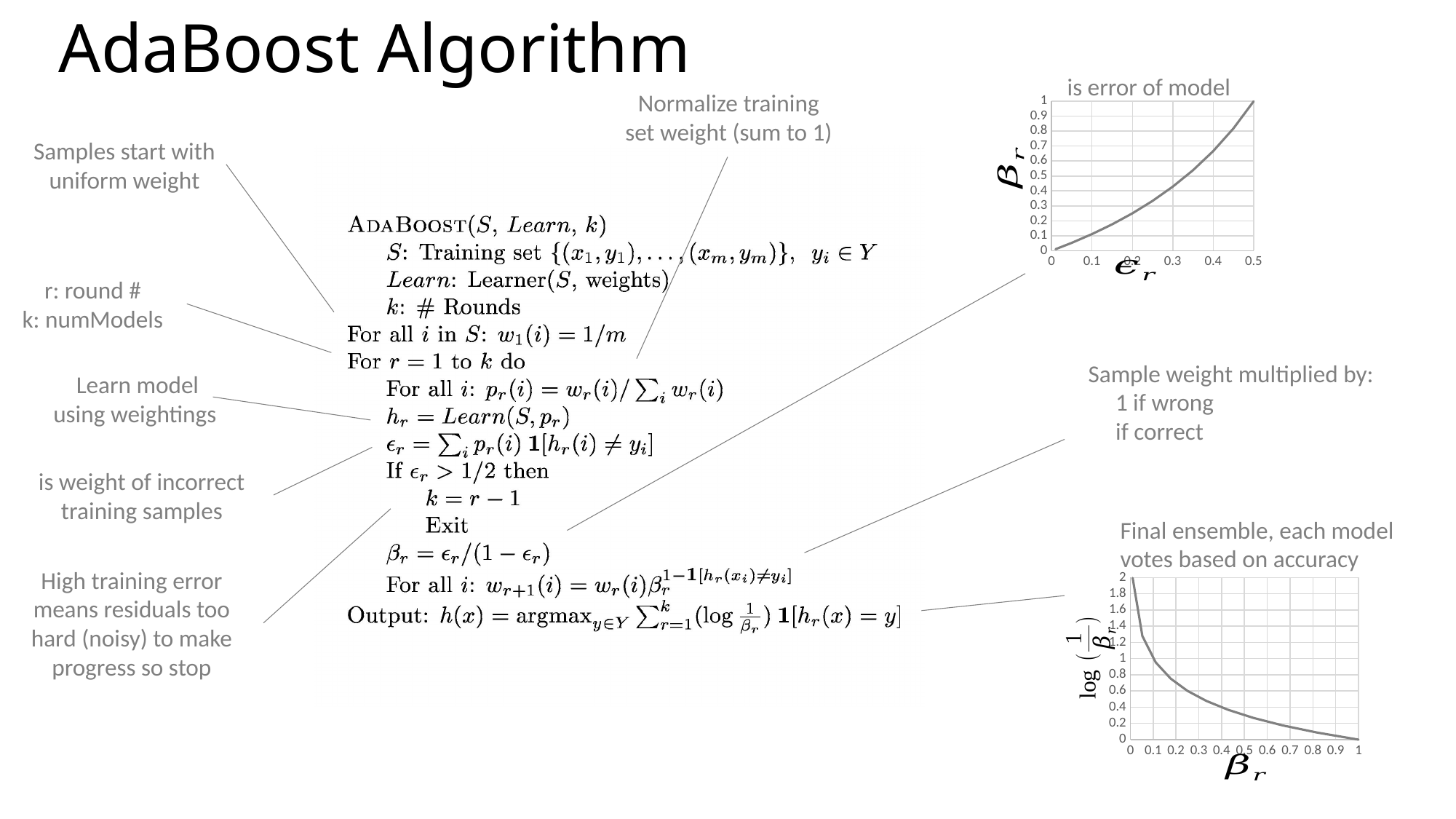
In the bottom-right chart (log(1/β_r) vs β_r), what is the maximum value shown on the y axis? 2 In the top-right chart (β_r vs ε_r), what is the maximum value shown on the x axis? 0.5 In the top-right chart (β_r vs ε_r), what is the value of β_r when ε_r is 0.5? 1 In the bottom-right chart (log(1/β_r) vs β_r), is the value at β_r = 0.5 greater or less than 0.6? less In the top-right chart (β_r vs ε_r), is the value of β_r at ε_r = 0.4 greater or less than 0.5? greater In the top-right chart (β_r vs ε_r), do the values rise or fall as ε_r increases along the x axis? rise What kind of chart is the top-right chart plotting β_r against ε_r? line chart In the top-right chart (β_r vs ε_r), is the value of β_r at ε_r = 0.1 greater or less than 0.2? less In the bottom-right chart (log(1/β_r) vs β_r), do the values rise or fall as β_r increases along the x axis? fall In the bottom-right chart (log(1/β_r) vs β_r), what is the value when β_r is 1? 0 What kind of chart is the bottom-right chart plotting log(1/β_r) against β_r? line chart